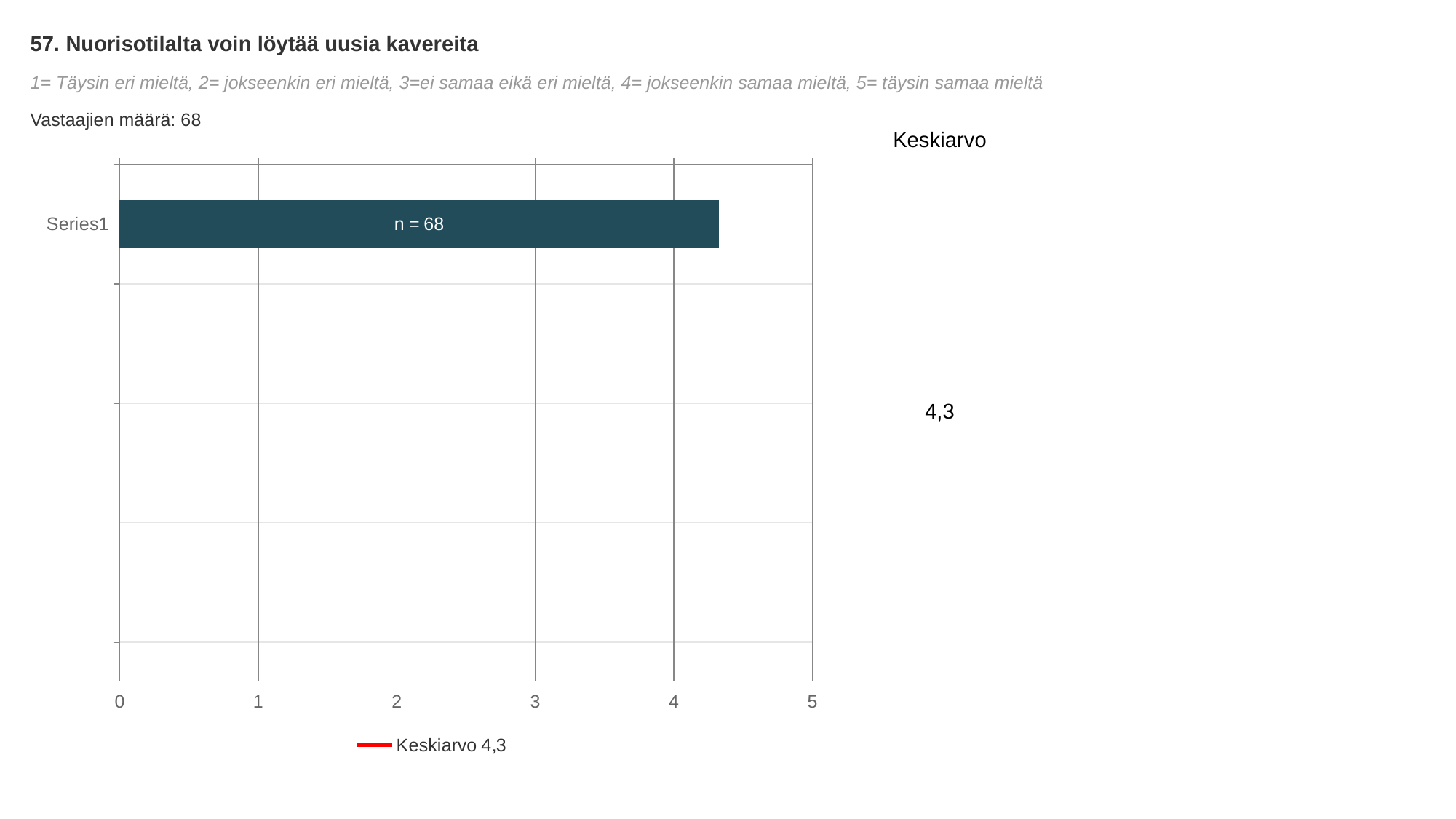
What kind of chart is shown on the slide? bar chart What is the highest value shown on the x axis? 5 Is the value of the Series1 bar greater or less than 3? greater What is the data label printed on the Series1 bar? n = 68 How many respondents (Vastaajien määrä) are reported on the slide? 68 What Keskiarvo (mean) value is shown on the slide? 4,3 What is the label of the category on the y axis? Series1 How many bars are plotted in the chart? 1 What is the title of the chart? 57. Nuorisotilalta voin löytää uusia kavereita Is the value of the Series1 bar greater or less than 5? less Is the value of the Series1 bar greater or less than 4? greater